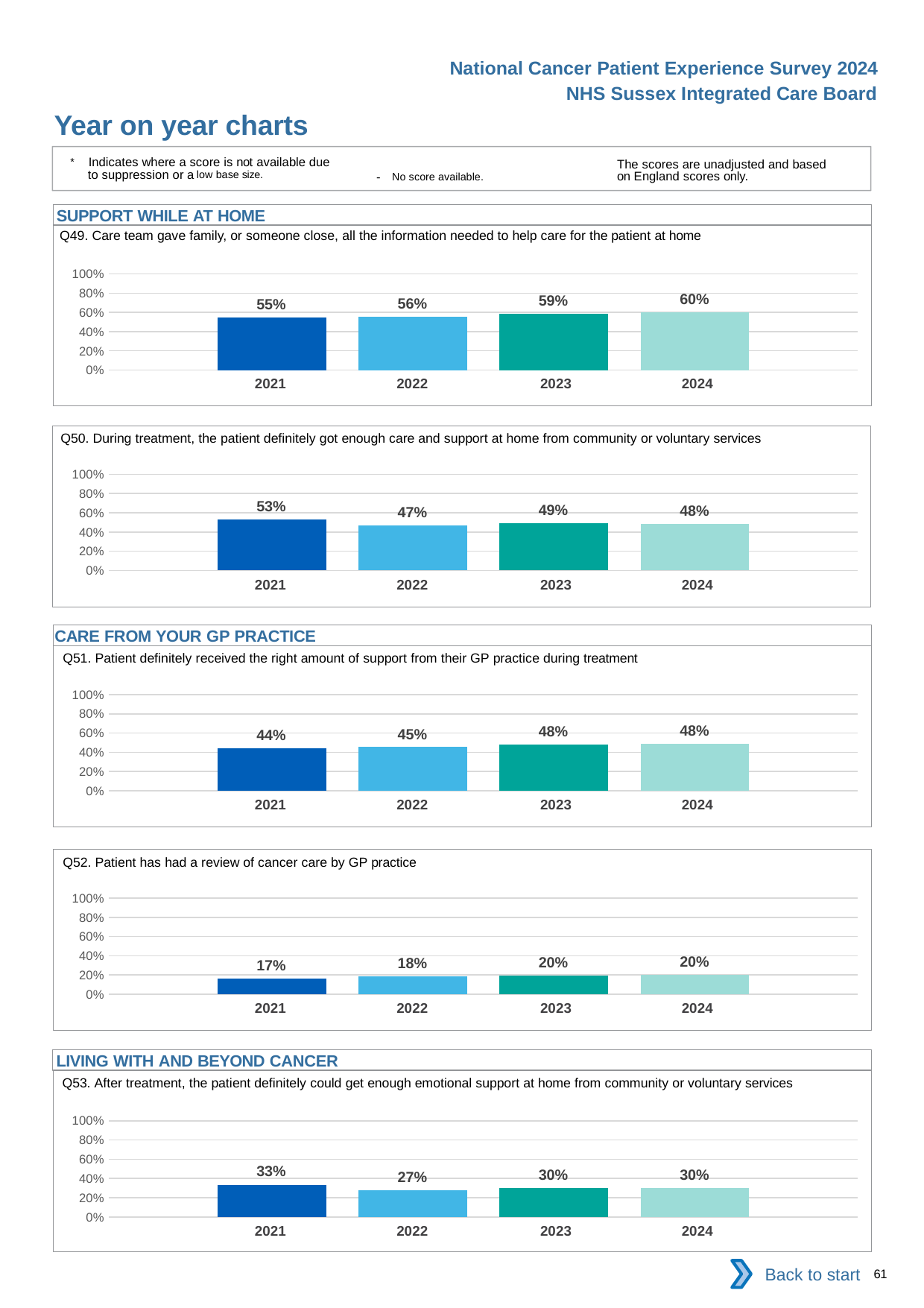
How many years are shown on the x axis of the Q49 chart? 4 In the Q52 chart, do the values generally rise or fall from 2021 to 2024? rise In the Q49 chart, what is the value for 2024? 60% In the Q49 chart, which year has the lowest value? 2021 In the Q50 chart, what is the difference between the 2021 and 2022 values? 6 percentage points What kind of chart is the Q50 chart? bar chart In the Q52 chart, what is the value for 2022? 18% In the Q53 chart, what is the difference between the 2021 and 2023 values? 3 percentage points In the Q50 chart, which year has the highest value? 2021 In the Q51 chart, what is the value for 2021? 44% In the Q51 chart, is the value for 2022 larger or smaller than the value for 2023? smaller In the Q53 chart, which year has the lowest value? 2022